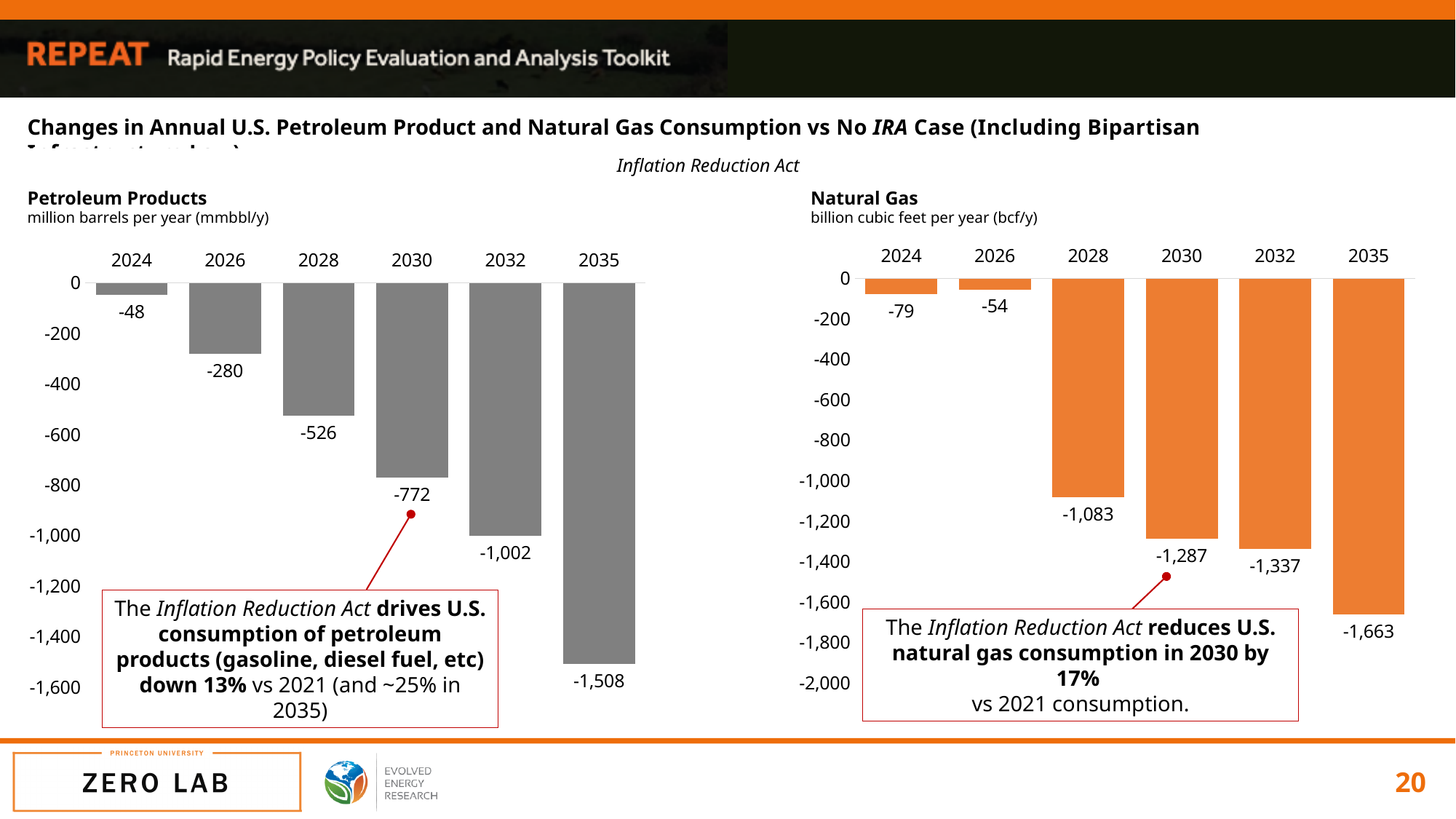
In the Natural Gas chart, what is the value for 2035? -1,663 In the Natural Gas chart, what is the value for 2028? -1,083 In the Petroleum Products chart, what is the value for 2024? -48 In the Natural Gas chart, which year has a larger reduction, 2030 or 2032? 2032 In the Petroleum Products chart, what is the difference between the 2035 value and the 2032 value? 506 What unit is used in the Natural Gas chart? billion cubic feet per year (bcf/y) In the Natural Gas chart, which year has the smallest reduction (value closest to zero)? 2026 In the Petroleum Products chart, which year has the largest reduction (lowest value)? 2035 In the Petroleum Products chart, what is the value for 2030? -772 In the Natural Gas chart, what is the difference between the 2030 value and the 2028 value? 204 How many years are plotted in the Petroleum Products chart? 6 What type of chart is the Natural Gas chart? Bar chart